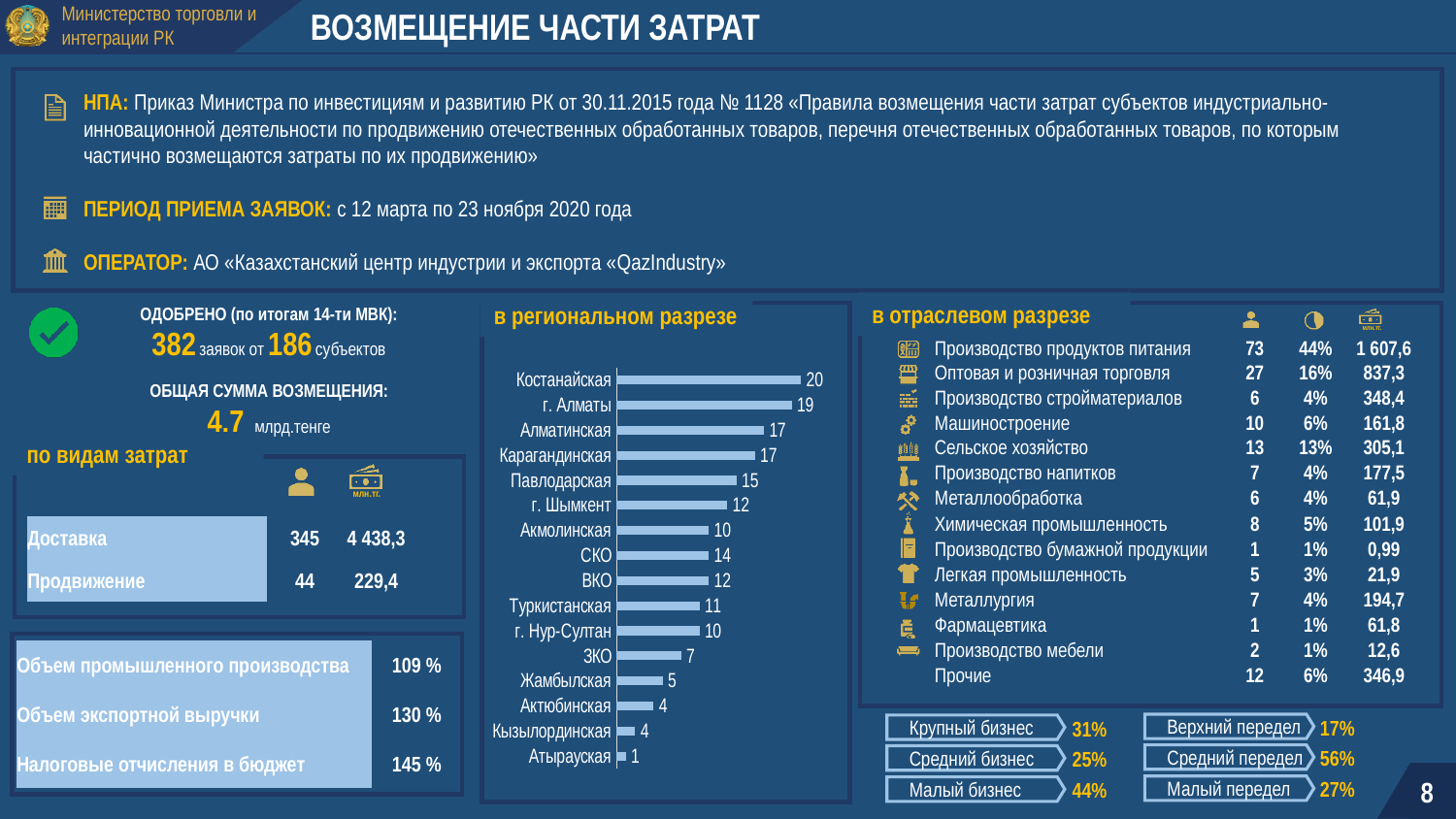
In the chart 'в региональном разрезе', which region has the lowest value? Атырауская In the chart 'в региональном разрезе', which is larger: the value for Туркестанская or the value for Жамбылская? Туркестанская How many regions are shown in the chart 'в региональном разрезе'? 16 In the chart 'в региональном разрезе', what is the difference between the values for Костанайская and Павлодарская? 5 In the chart 'в региональном разрезе', which region has the highest value? Костанайская In the chart 'в региональном разрезе', what is the value for г. Нур-Султан? 10 In the chart 'в региональном разрезе', what is the difference between the values for г. Алматы and ЗКО? 12 In the chart 'в региональном разрезе', what is the value for Костанайская? 20 What type of chart is 'в региональном разрезе'? bar chart In the chart 'в региональном разрезе', what is the value for г. Шымкент? 12 In the chart 'в региональном разрезе', which is larger: the value for СКО or the value for ВКО? СКО In the chart 'в региональном разрезе', what is the value for СКО? 14